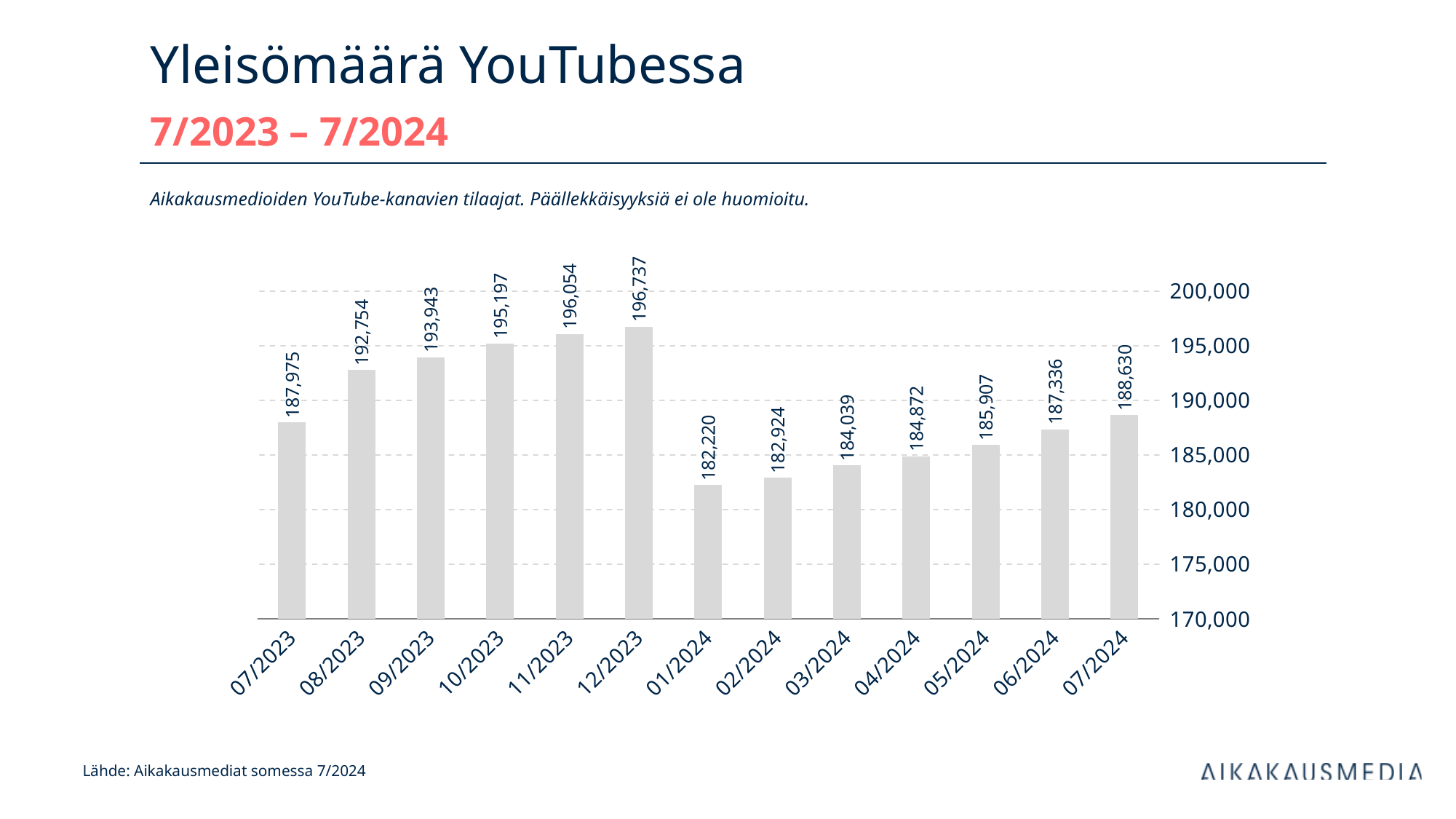
What is the value for 12/2023? 196,737 What is the difference between the values for 07/2024 and 07/2023? 655 What is the value for 01/2024? 182,220 What kind of chart is shown on the slide? bar chart Do the values rise or fall from 01/2024 to 07/2024? rise Which is larger, the value for 09/2023 or the value for 06/2024? 09/2023 How many months are shown on the x axis? 13 Is the value for 11/2023 greater or less than 195,000? greater What is the value for 07/2024? 188,630 What is the difference between the values for 12/2023 and 01/2024? 14,517 Which month has the highest value? 12/2023 Which month has the lowest value? 01/2024